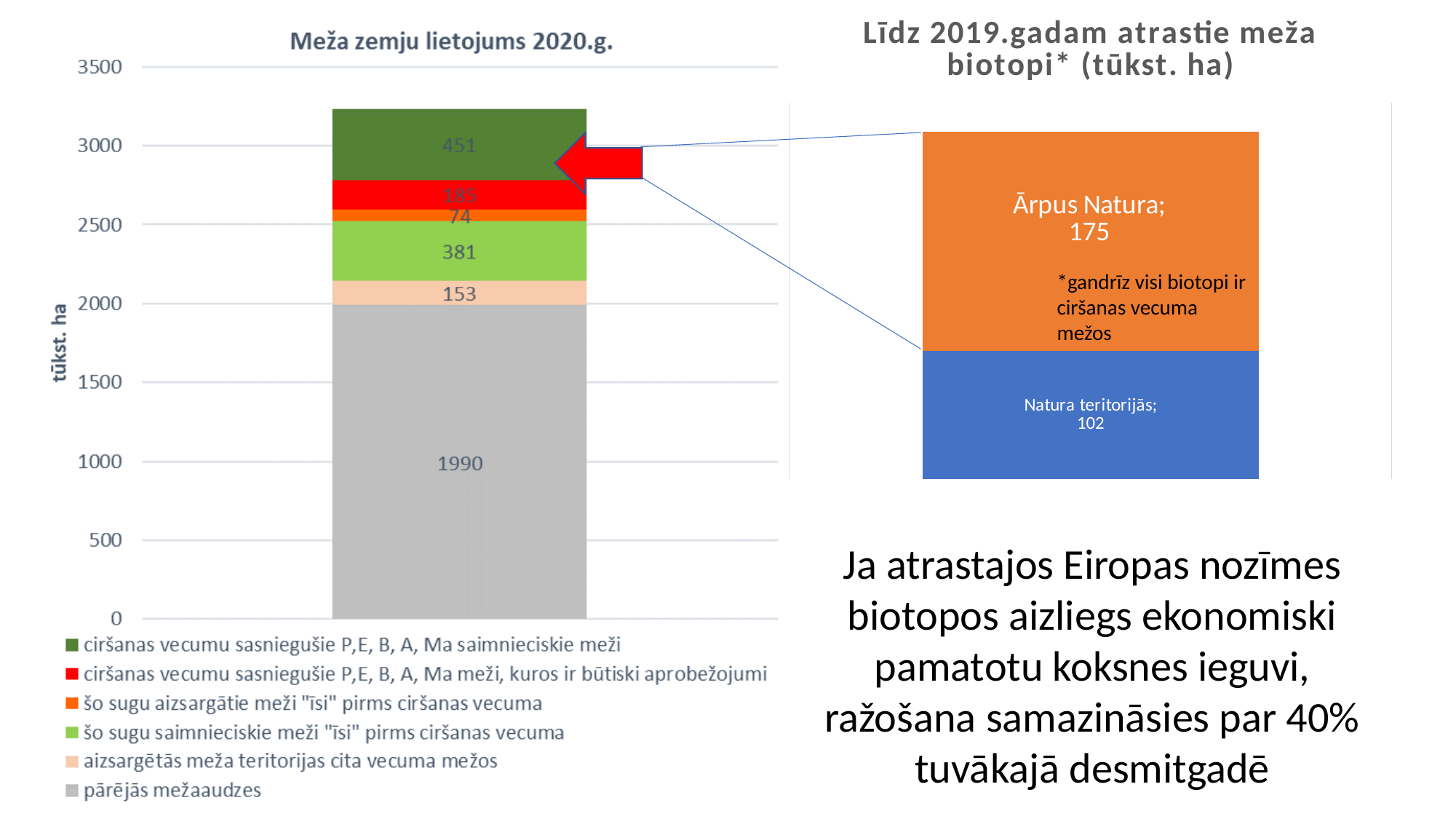
In the chart 'Līdz 2019.gadam atrastie meža biotopi* (tūkst. ha)', what is the total of the stacked bar? 277 What kind of chart is 'Meža zemju lietojums 2020.g.'? stacked bar chart In the chart 'Meža zemju lietojums 2020.g.', what is the total of the stacked bar? 3234 In the chart 'Meža zemju lietojums 2020.g.', how many series does the legend list? 6 In the chart 'Līdz 2019.gadam atrastie meža biotopi* (tūkst. ha)', what is the value for 'Natura teritorijās'? 102 In the chart 'Meža zemju lietojums 2020.g.', what is the difference between the values 381 and 153? 228 In the chart 'Meža zemju lietojums 2020.g.', which series has the smallest value? šo sugu aizsargātie meži "īsi" pirms ciršanas vecuma In the chart 'Meža zemju lietojums 2020.g.', which series has the largest value? pārējās mežaaudzes In the chart 'Līdz 2019.gadam atrastie meža biotopi* (tūkst. ha)', which is larger, 'Ārpus Natura' or 'Natura teritorijās'? Ārpus Natura In the chart 'Meža zemju lietojums 2020.g.', what is the value for 'šo sugu aizsargātie meži "īsi" pirms ciršanas vecuma'? 74 In the chart 'Meža zemju lietojums 2020.g.', what is the value for 'pārējās mežaaudzes'? 1990 In the chart 'Meža zemju lietojums 2020.g.', what is the value for 'cirsanas vecumu sasniegušie P,E, B, A, Ma saimnieciskie meži'? 451